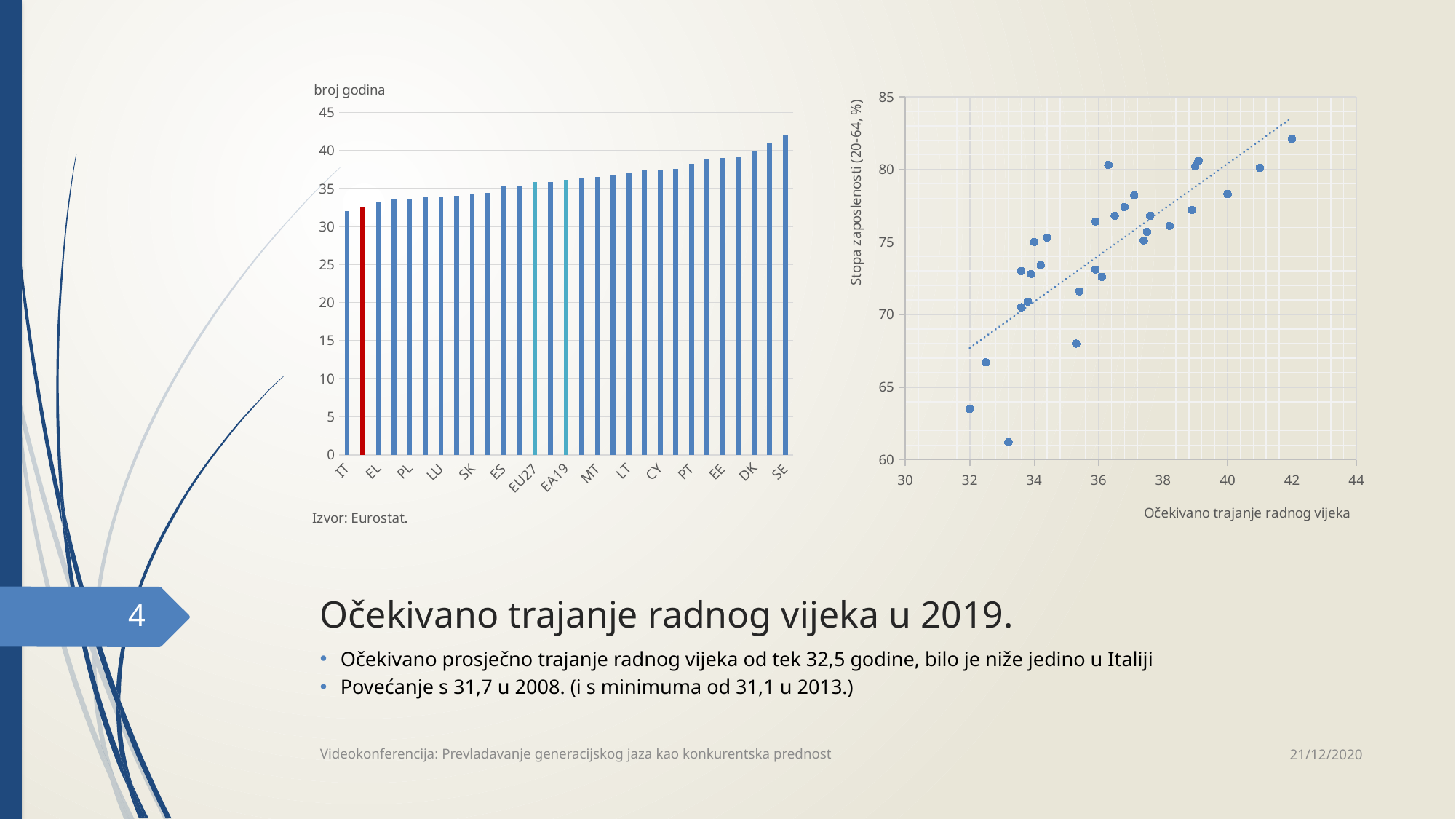
In the right scatter plot, does the dotted trend line rise or fall as the x value increases? rise In the left bar chart, is the value for SE greater or less than 40? greater What kind of chart is the left chart on the slide? bar chart What kind of chart is the right chart on the slide? scatter plot In the right scatter plot, what is the title of the horizontal axis? Očekivano trajanje radnog vijeka In the left bar chart, is the value for IT greater or less than 35? less In the left bar chart, which labelled category has the lowest bar? IT In the left bar chart, do the bars rise or fall from left to right? rise In the left bar chart, which is larger, the value for EE or the value for EL? EE In the left bar chart, which labelled category has the highest bar? SE In the left bar chart, what is the label shown above the vertical axis? broj godina In the left bar chart, is the value for DK greater or less than 35? greater